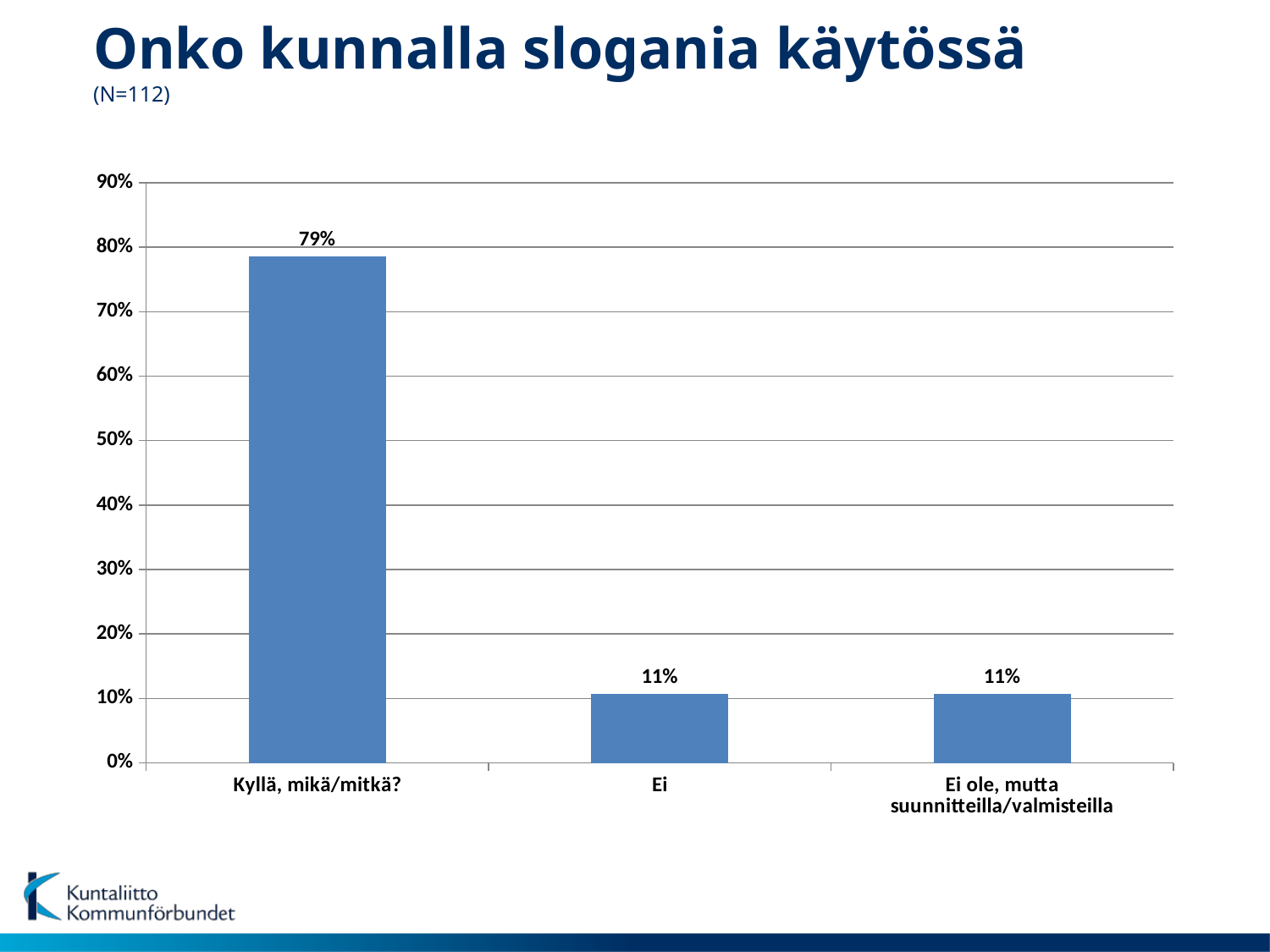
Which is larger, the value for "Kyllä, mikä/mitkä?" or the value for "Ei ole, mutta suunnitteilla/valmisteilla"? Kyllä, mikä/mitkä? What is the difference between the values for "Kyllä, mikä/mitkä?" and "Ei"? 68% What is the title of the slide? Onko kunnalla slogania käytössä What is the value for "Ei ole, mutta suunnitteilla/valmisteilla"? 11% Is the value for "Ei" greater or less than 20%? less How many categories are shown on the x axis? 3 Which category has the highest value? Kyllä, mikä/mitkä? What is the value for "Ei"? 11% What kind of chart is shown on the slide? Bar chart Is the value for "Kyllä, mikä/mitkä?" greater or less than 70%? greater What is the sample size (N) stated under the title? N=112 What is the value for "Kyllä, mikä/mitkä?"? 79%